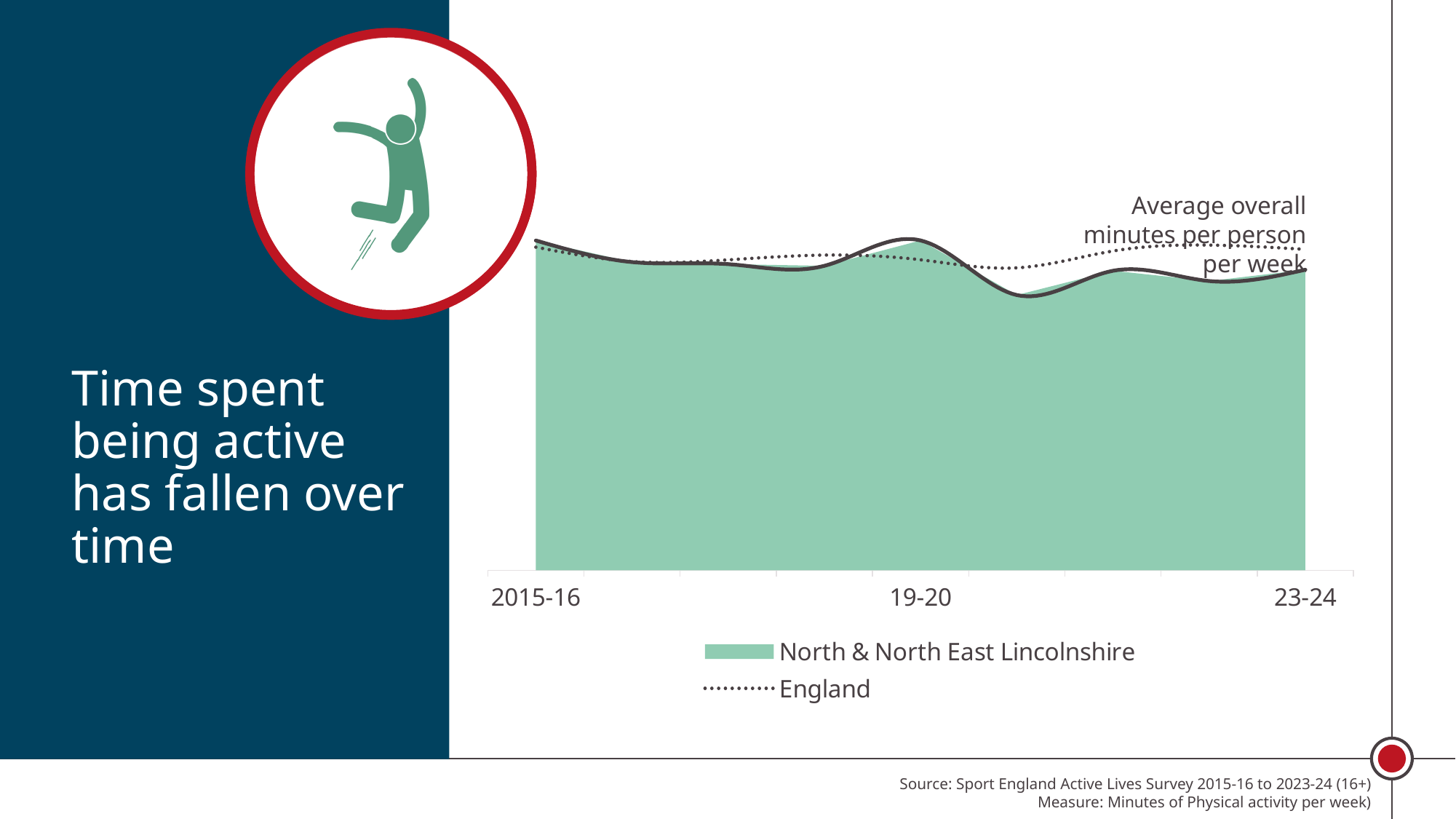
How many year labels are printed on the x axis of the chart? 3 What is the last year label on the x axis of the chart? 23-24 At 19-20, which series has the higher value: North & North East Lincolnshire or England? North & North East Lincolnshire What is the first year label on the x axis of the chart? 2015-16 Which series is shown as a shaded green area in the chart? North & North East Lincolnshire What measure does the chart annotation say is plotted? Average overall minutes per person per week How many series does the chart legend list? 2 What kind of chart is shown on the slide? Area and line chart For North & North East Lincolnshire, is the value higher in 2015-16 or in 23-24? 2015-16 Which series is shown as a dotted line in the chart? England Does the value for North & North East Lincolnshire rise or fall overall from 2015-16 to 23-24? Fall